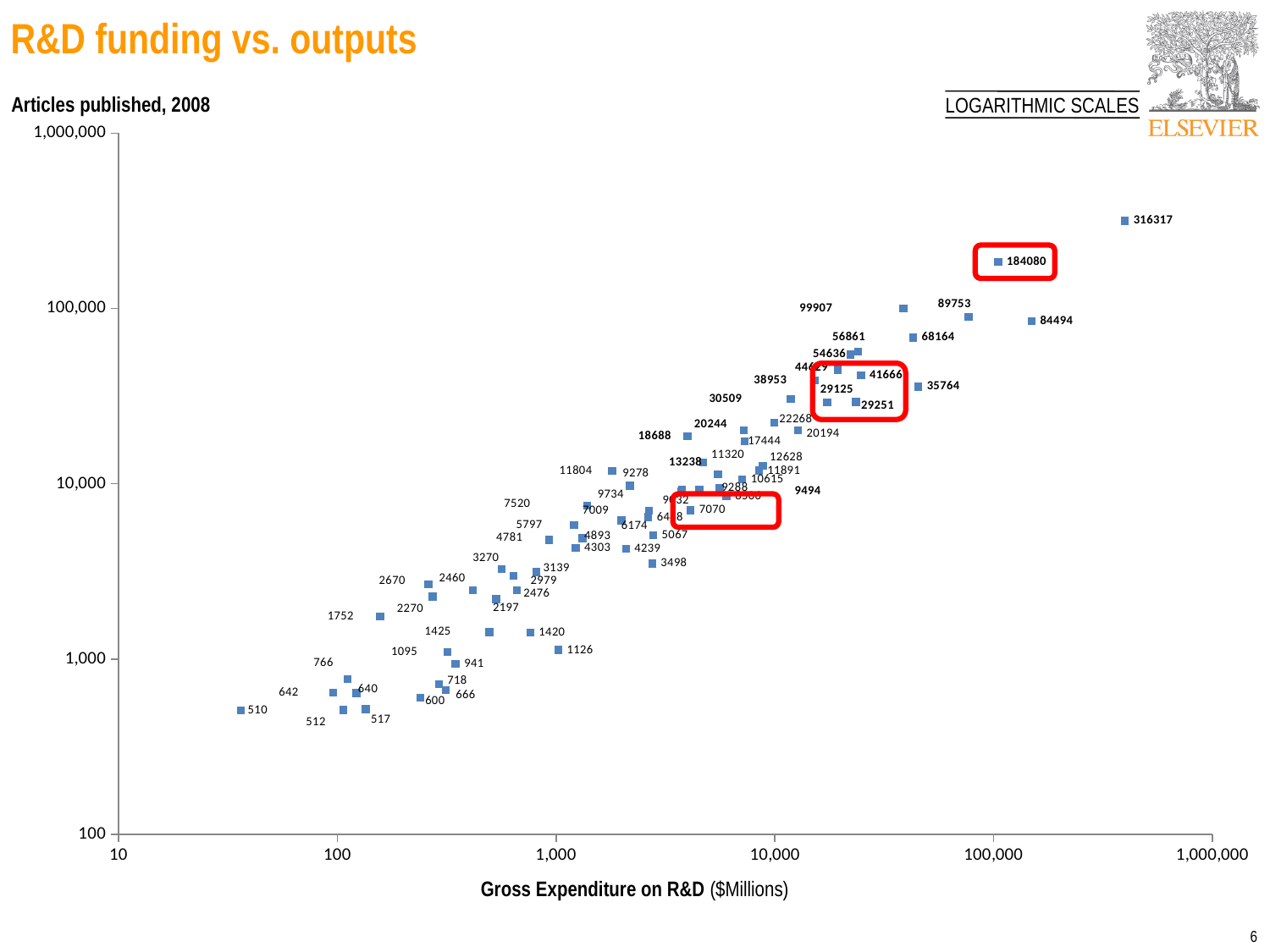
Which value is labeled inside the highest red box on the chart? 184080 What is the highest article count labeled on the chart? 316317 What kind of scales does the chart use, according to the note at the top right? Logarithmic scales What kind of chart is shown on the slide? Scatter chart Which value is labeled inside the lowest red box on the chart? 7070 What is the label of the x axis? Gross Expenditure on R&D ($Millions) Is the point labeled 316317 greater or less than 100,000 on the y axis? greater Which is larger, the value labeled 89753 or the value labeled 84494? 89753 What is the difference between the two highest labeled values, 316317 and 184080? 132237 Is the point labeled 510 greater or less than 1,000 on the y axis? less Do the article counts generally rise or fall as gross expenditure on R&D increases along the x axis? Rise What is the lowest article count labeled on the chart? 510